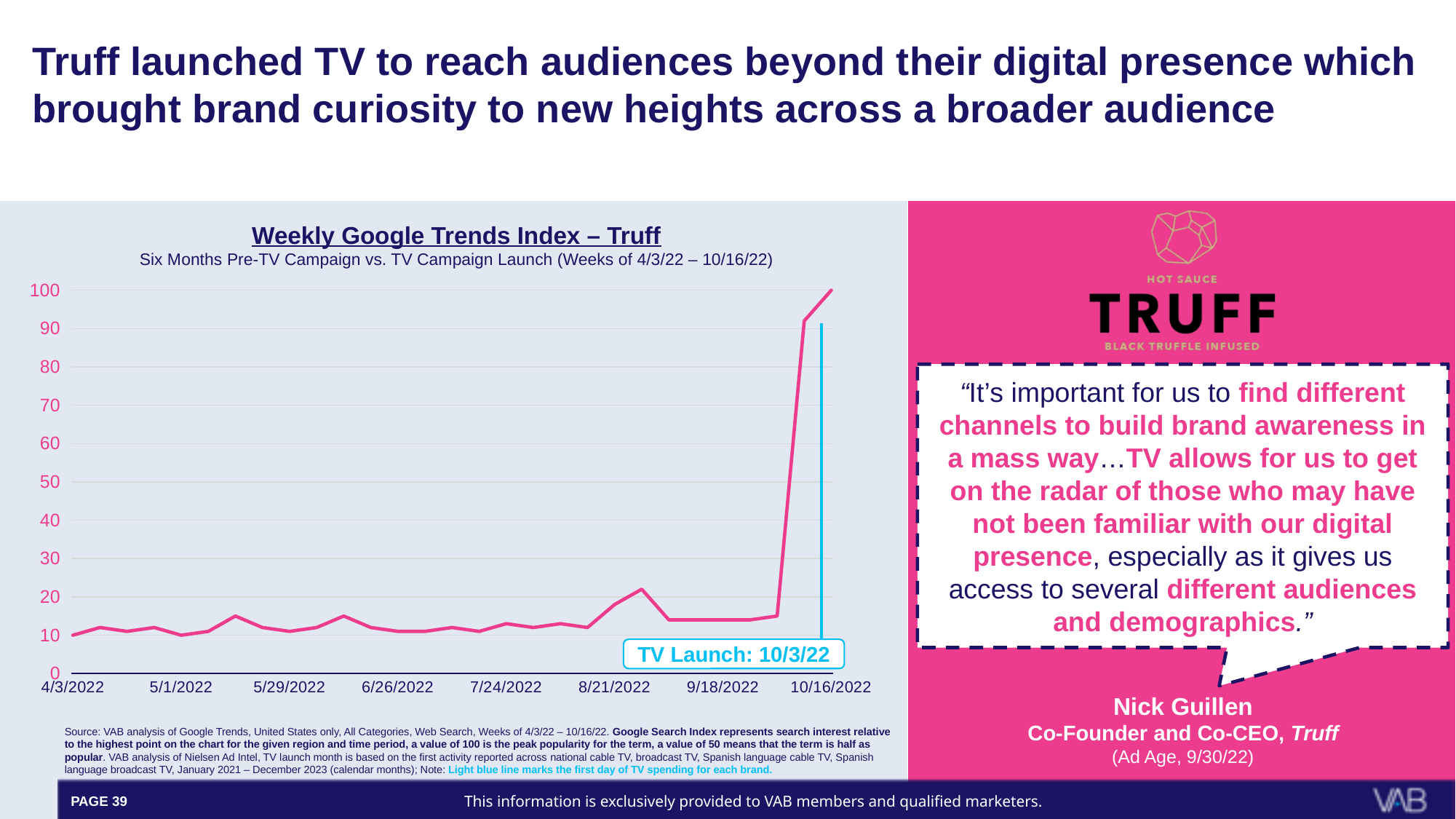
How does the Google Trends Index change after the TV launch compared with the months before it? It rises sharply What date does the TV Launch callout on the chart give? 10/3/22 Is the value for the week of 9/18/2022 greater or less than 30? less Is the value for the week of 8/21/2022 greater or less than 30? less What kind of chart is shown on the slide? line chart Which week has the highest Google Trends Index value? 10/16/2022 How many date labels are shown on the x axis of the chart? 8 What is the Google Trends Index value for the week of 10/16/2022? 100 Is the value for the week of 4/3/2022 greater or less than 20? less What is the title of the chart? Weekly Google Trends Index – Truff Which is larger, the value for the week of 10/16/2022 or the value for the week of 4/3/2022? 10/16/2022 Which is larger, the value for the week of 8/21/2022 or the value for the week of 9/18/2022? 8/21/2022